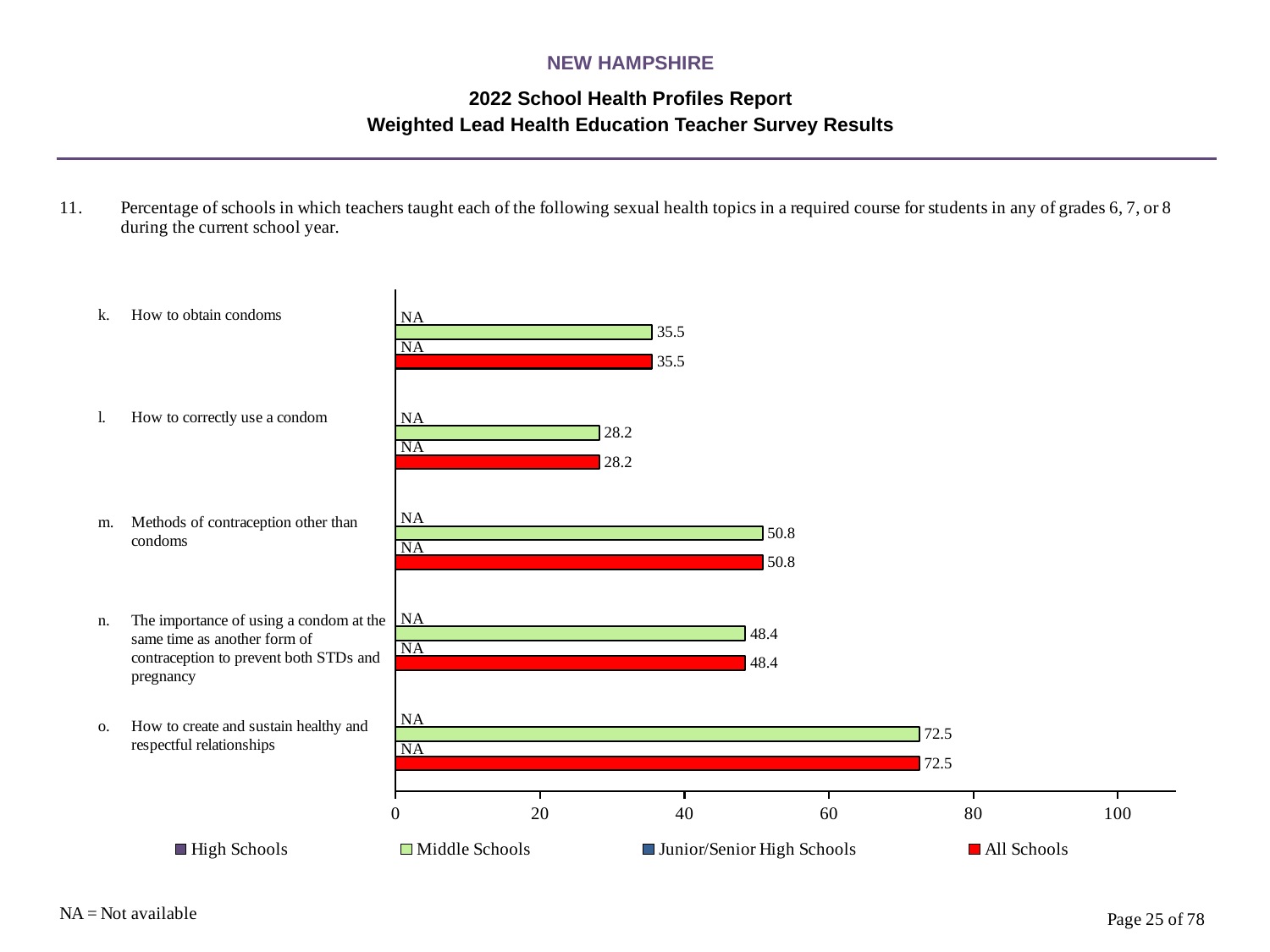
What kind of chart is shown on the slide? Bar chart How many topics are listed on the chart? 5 What is the Middle Schools value for 'Methods of contraception other than condoms'? 50.8 What is the difference between the Middle Schools values for 'How to create and sustain healthy and respectful relationships' and 'How to obtain condoms'? 37.0 How many series does the legend list? 4 What is the Middle Schools value for 'How to obtain condoms'? 35.5 What value is shown for High Schools for 'How to obtain condoms'? NA What is the All Schools value for 'How to correctly use a condom'? 28.2 Which topic has the lowest Middle Schools value? How to correctly use a condom Which is larger for All Schools: 'Methods of contraception other than condoms' or 'The importance of using a condom at the same time as another form of contraception to prevent both STDs and pregnancy'? Methods of contraception other than condoms What is the All Schools value for 'How to create and sustain healthy and respectful relationships'? 72.5 Which topic has the highest All Schools value? How to create and sustain healthy and respectful relationships